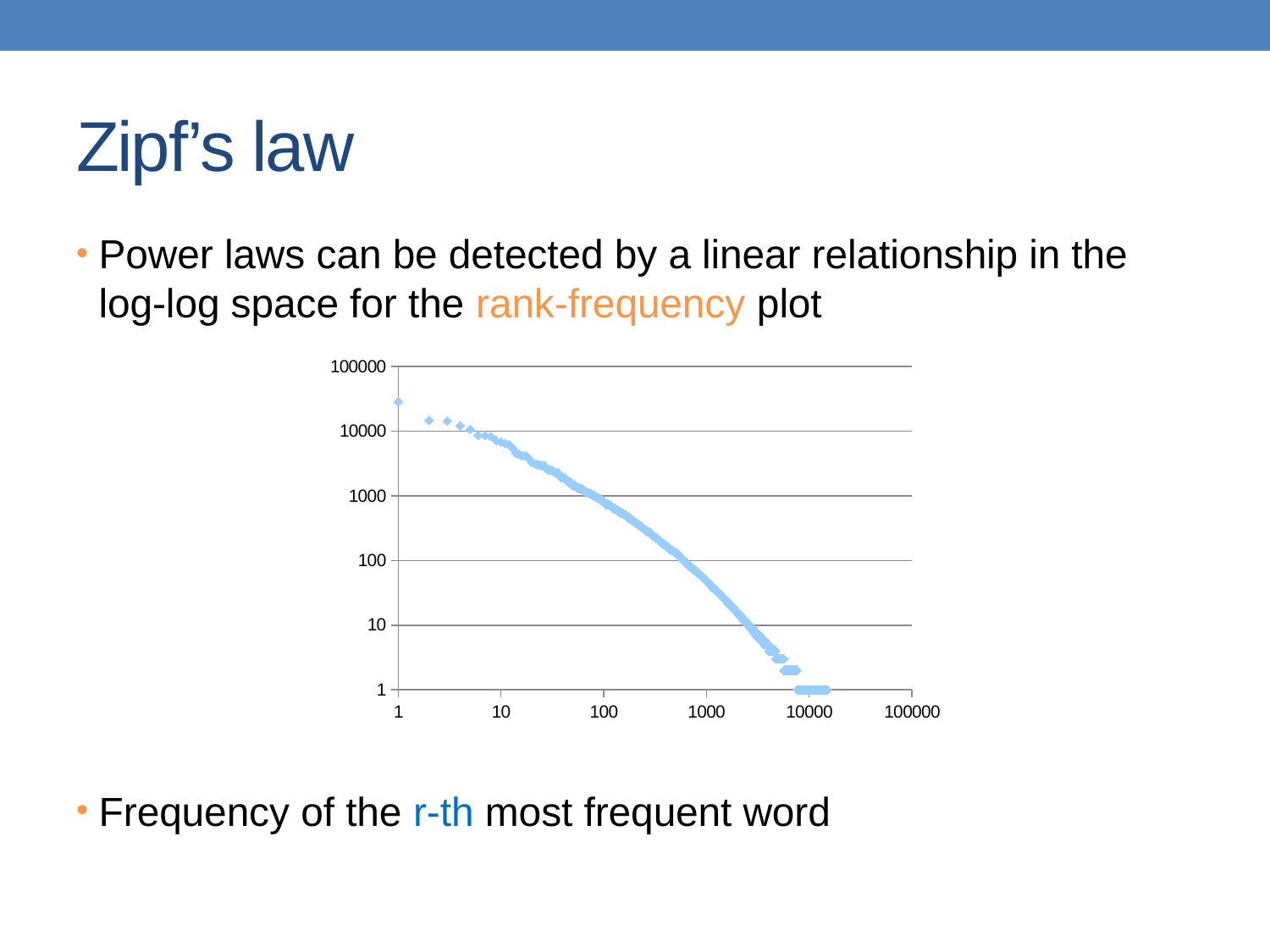
What is the smallest tick label shown on the x axis? 1 Is the frequency plotted at rank 10 greater or less than 1000? greater How many tick labels are shown on the x axis? 6 What kind of chart is shown on the slide? scatter chart Is the frequency plotted at rank 1 greater or less than 10000? greater Is the frequency plotted at rank 1 greater or less than 100000? less What is the lowest frequency value that the plotted points reach on the y axis? 1 Do the plotted values rise or fall as rank increases along the x axis? fall What is the highest tick label shown on the y axis? 100000